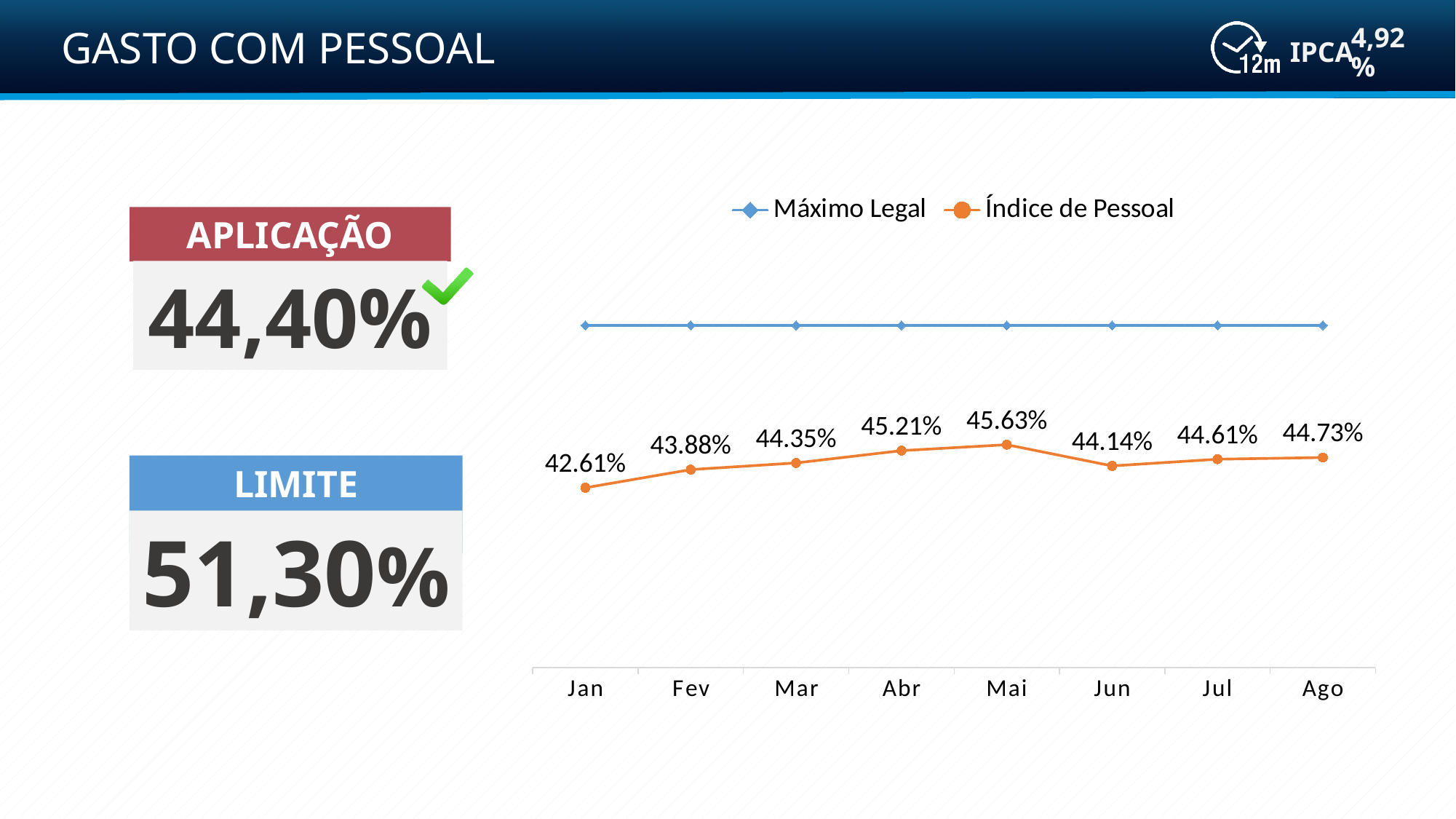
What is the difference between the Índice de Pessoal values for Mai and Jun? 1.49% How many series does the chart legend list? 2 How many months are shown on the x axis of the chart? 8 In which month is Índice de Pessoal lowest? Jan Does the Índice de Pessoal line rise or fall from Jan to Mai? Rise What is the value of Índice de Pessoal in Mai? 45.63% What kind of chart is shown on the slide? Line chart In which month is Índice de Pessoal highest? Mai What is the value of Índice de Pessoal in Jan? 42.61% Which series in the chart is drawn in orange? Índice de Pessoal What is the value of Índice de Pessoal in Ago? 44.73% Which month has a higher Índice de Pessoal value, Abr or Jul? Abr